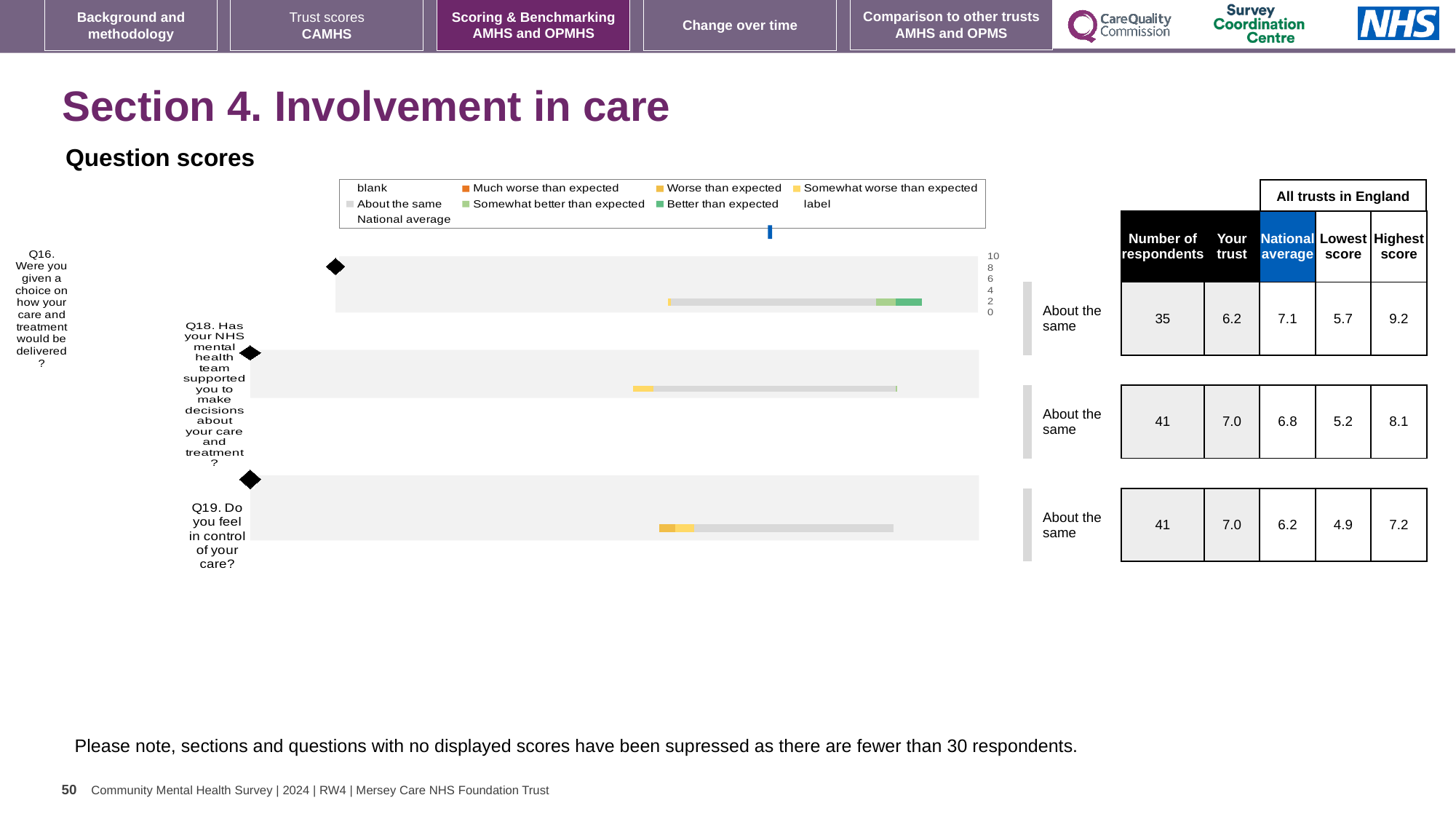
What is the highest score among all trusts in England for Q19? 7.2 How many questions are plotted in the chart? 3 What benchmark category is shown for Q18? About the same Which question has the highest national average score? Q16 What is the lowest score among all trusts in England for Q16? 5.7 What is the difference between the trust's score and the national average for Q19? 0.8 What is the national average score for Q18 (Has your NHS mental health team supported you to make decisions about your care and treatment?)? 6.8 How many respondents answered Q19 (Do you feel in control of your care?)? 41 What is the trust's score for Q16 (Were you given a choice on how your care and treatment would be delivered?)? 6.2 Is the trust's score for Q16 higher or lower than the national average? lower What kind of chart is used to show the question scores? bar chart Which question has the lowest number of respondents? Q16